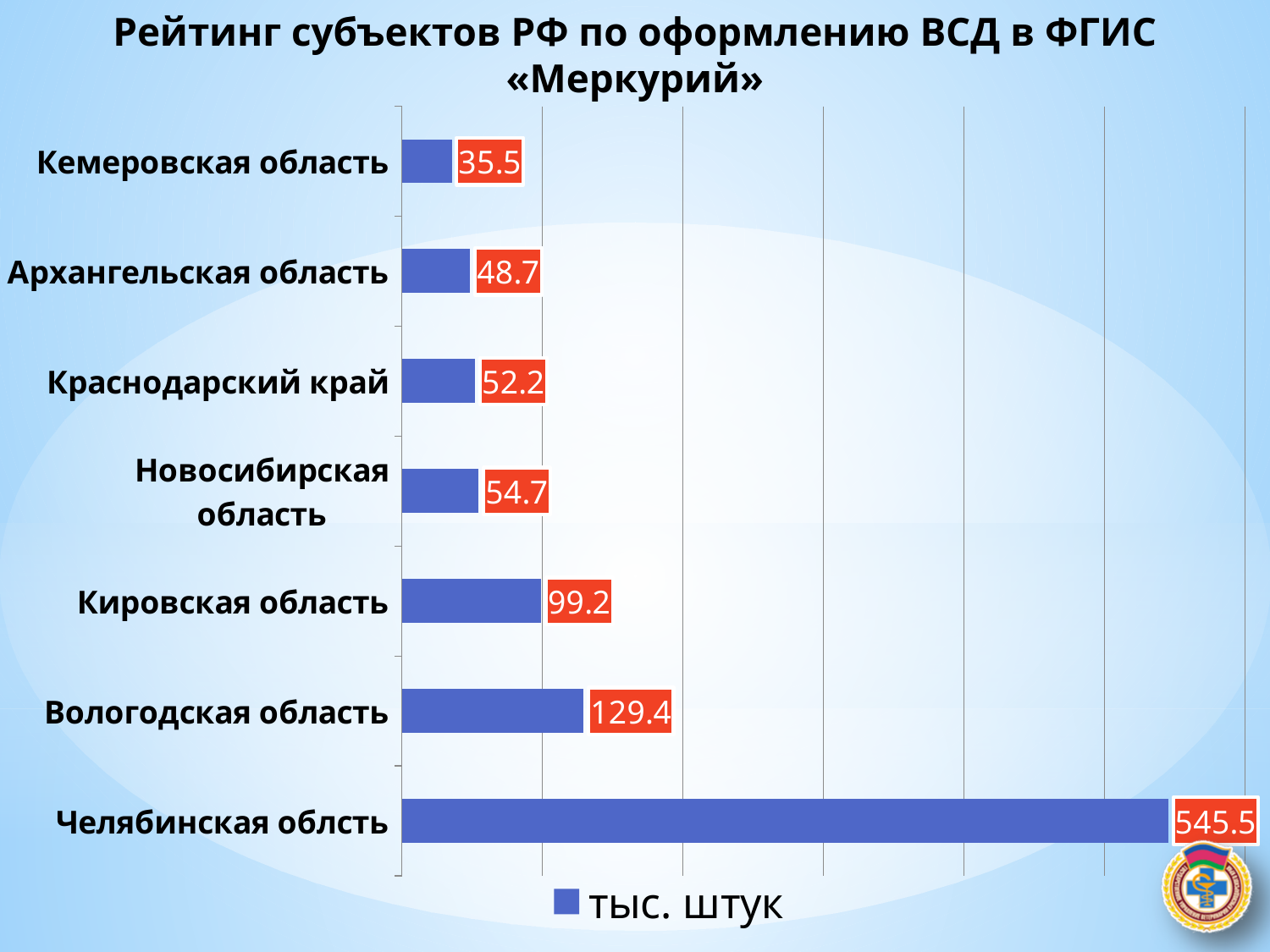
What is the value for Вологодская область? 129.4 What kind of chart is shown on the slide? Bar chart Which region has the highest value? Челябинская область What is the value for Кемеровская область? 35.5 What is the value for Кировская область? 99.2 Which region has the lowest value? Кемеровская область How many regions are shown in the chart? 7 What is the difference between the values for Вологодская область and Кировская область? 30.2 Which is larger, the value for Краснодарский край or the value for Архангельская область? Краснодарский край What is the difference between the values for Челябинская область and Вологодская область? 416.1 What unit does the legend give for the values? тыс. штук What is the value for Челябинская область? 545.5